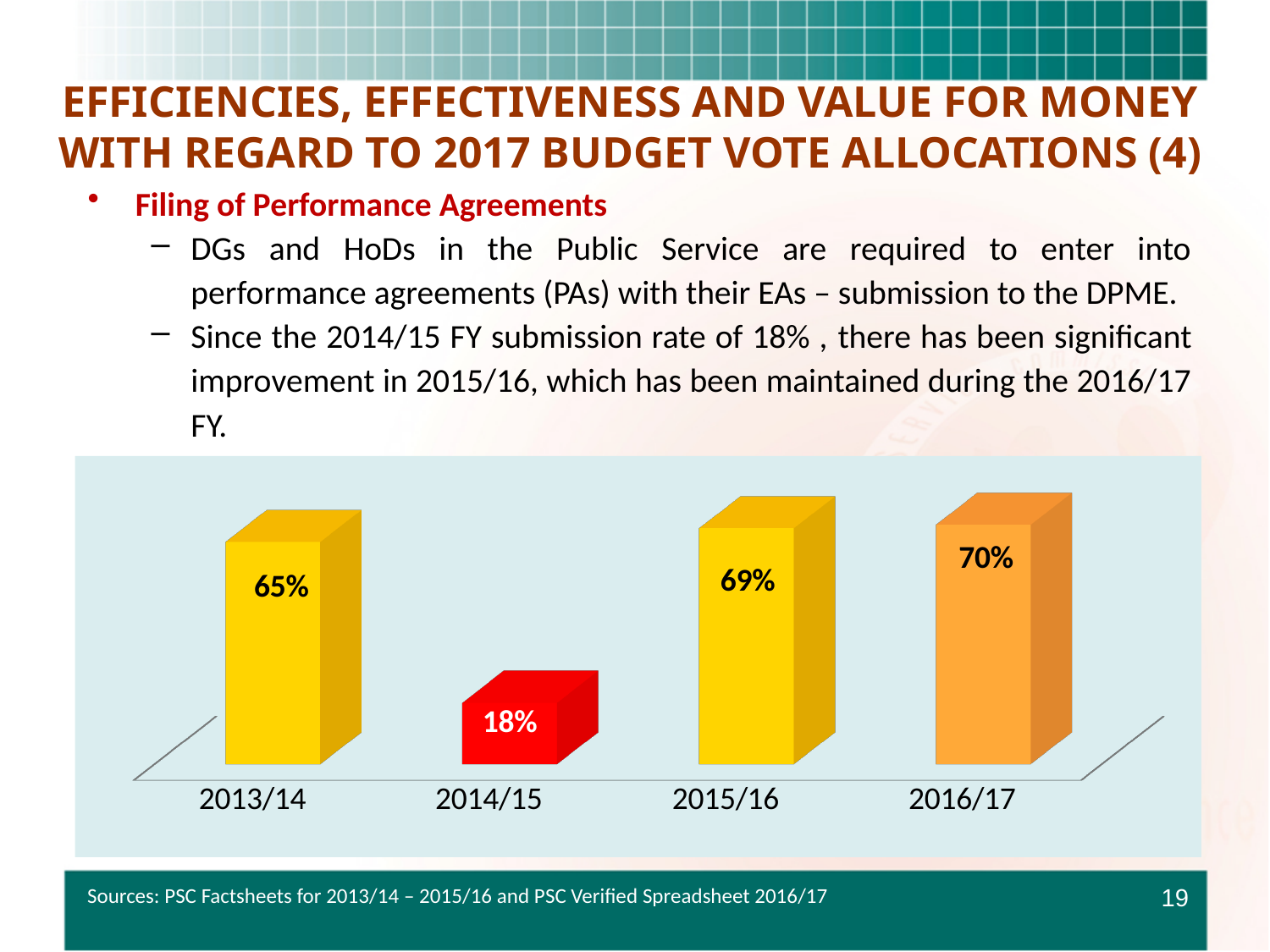
What is the value for 2013/14? 65% Which year has the lowest value? 2014/15 Which year has the highest value? 2016/17 Which is larger, the value for 2013/14 or the value for 2014/15? 2013/14 What is the value for 2016/17? 70% What is the value for 2015/16? 69% What is the value for 2014/15? 18% What is the difference between the values for 2016/17 and 2013/14? 5% What is the difference between the values for 2015/16 and 2014/15? 51% How many years are shown on the chart? 4 What kind of chart is shown on the slide? Bar chart Which bar is coloured red? 2014/15